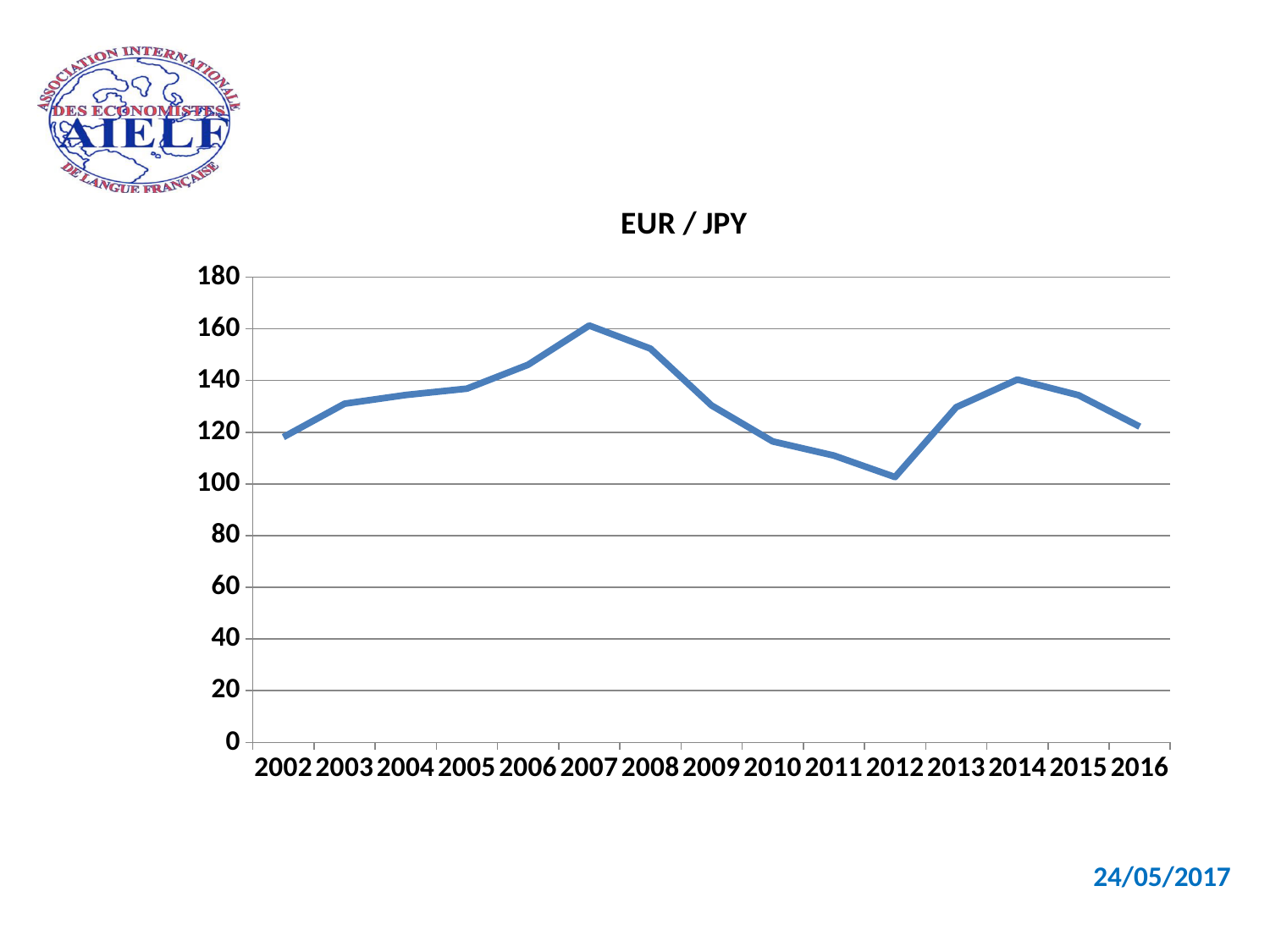
What is the title of the chart? EUR / JPY Which year has the higher value, 2014 or 2010? 2014 In which year does the EUR / JPY line reach its highest value? 2007 Is the value for 2012 greater or less than 120? less How many years are plotted along the x axis? 15 Which year has the higher value, 2007 or 2012? 2007 Is the value for 2011 greater or less than 120? less Does the EUR / JPY line rise or fall between 2007 and 2012? Falls In which year does the EUR / JPY line reach its lowest value? 2012 Is the value for 2007 greater or less than 140? greater What kind of chart is shown on the slide? Line chart